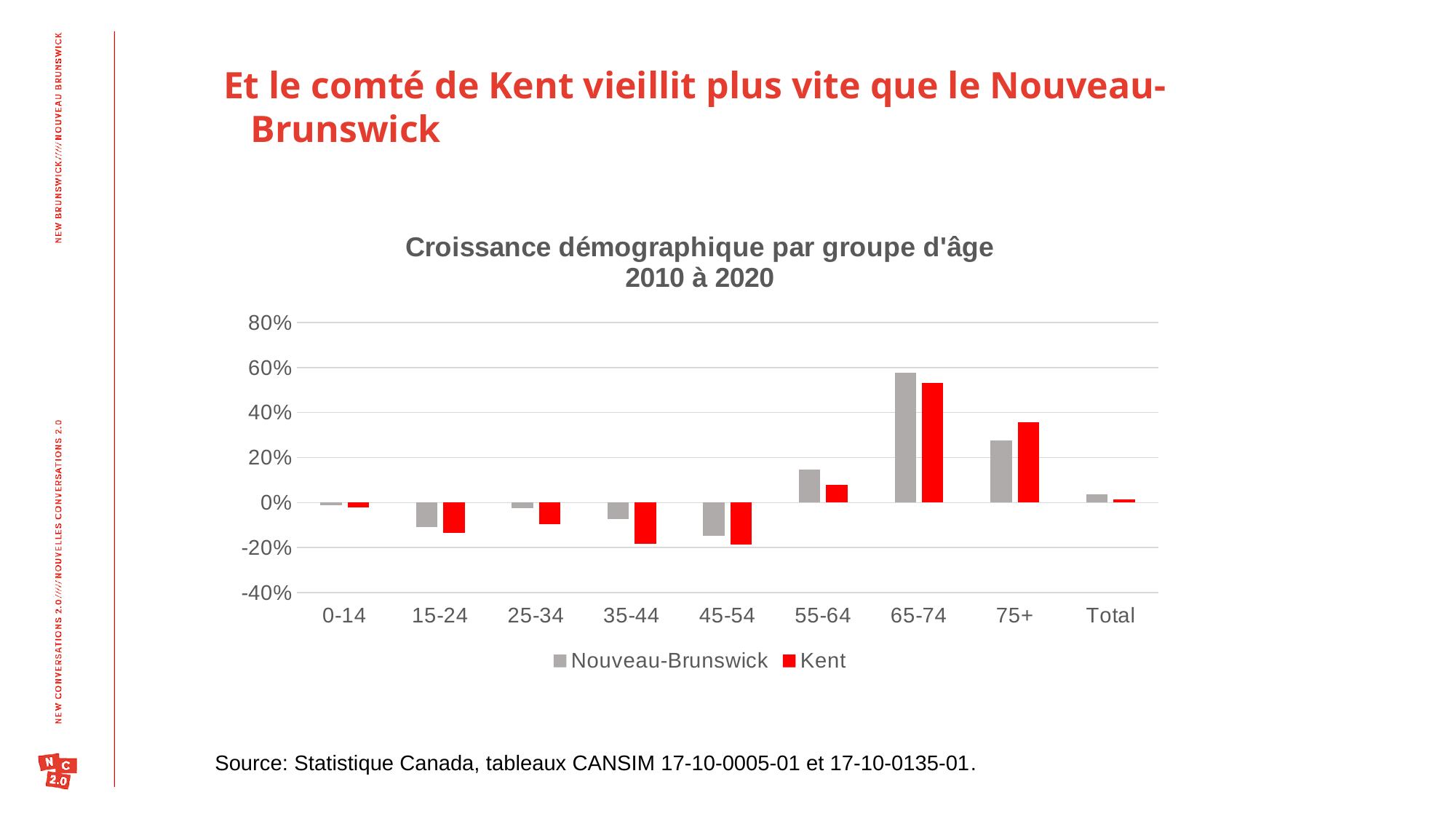
Is the value for Kent in the 35-44 age group greater or less than -10%? less What colour represents Kent in the chart? red How many series does the legend list? 2 Which age group has the highest value for Nouveau-Brunswick? 65-74 How many categories are shown on the x axis? 9 What kind of chart is shown on the slide? bar chart Which age group has the lowest value for Nouveau-Brunswick? 45-54 For the 75+ age group, which is larger: Nouveau-Brunswick or Kent? Kent What is the title of the chart? Croissance démographique par groupe d'âge 2010 à 2020 Is the value for Kent in the 65-74 age group greater or less than 40%? greater For the 55-64 age group, which is larger: Nouveau-Brunswick or Kent? Nouveau-Brunswick Which age group has the highest value for Kent? 65-74